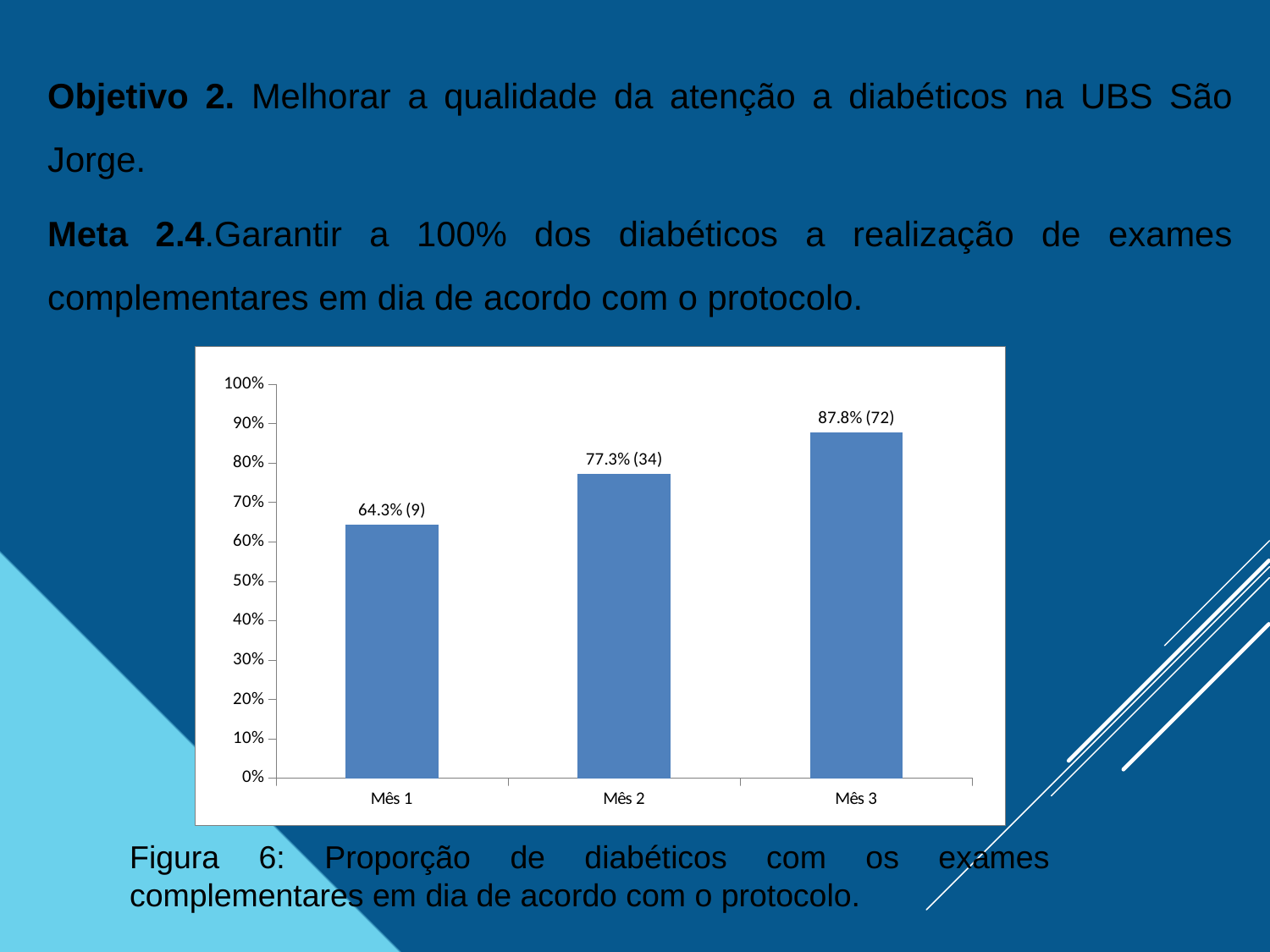
What is the value shown for Mês 3? 87.8% (72) Which month has the highest proportion? Mês 3 Do the values rise or fall from Mês 1 to Mês 3? rise Is the value for Mês 2 greater or less than 70%? greater What kind of chart is shown? bar chart Which is larger, the value for Mês 2 or the value for Mês 1? Mês 2 What is the difference in percentage points between Mês 3 and Mês 1? 23.5 Which month has the lowest proportion? Mês 1 What is the value shown for Mês 2? 77.3% (34) How many months are shown on the x axis? 3 What is the figure caption below the chart? Figura 6: Proporção de diabéticos com os exames complementares em dia de acordo com o protocolo. What is the value shown for Mês 1? 64.3% (9)